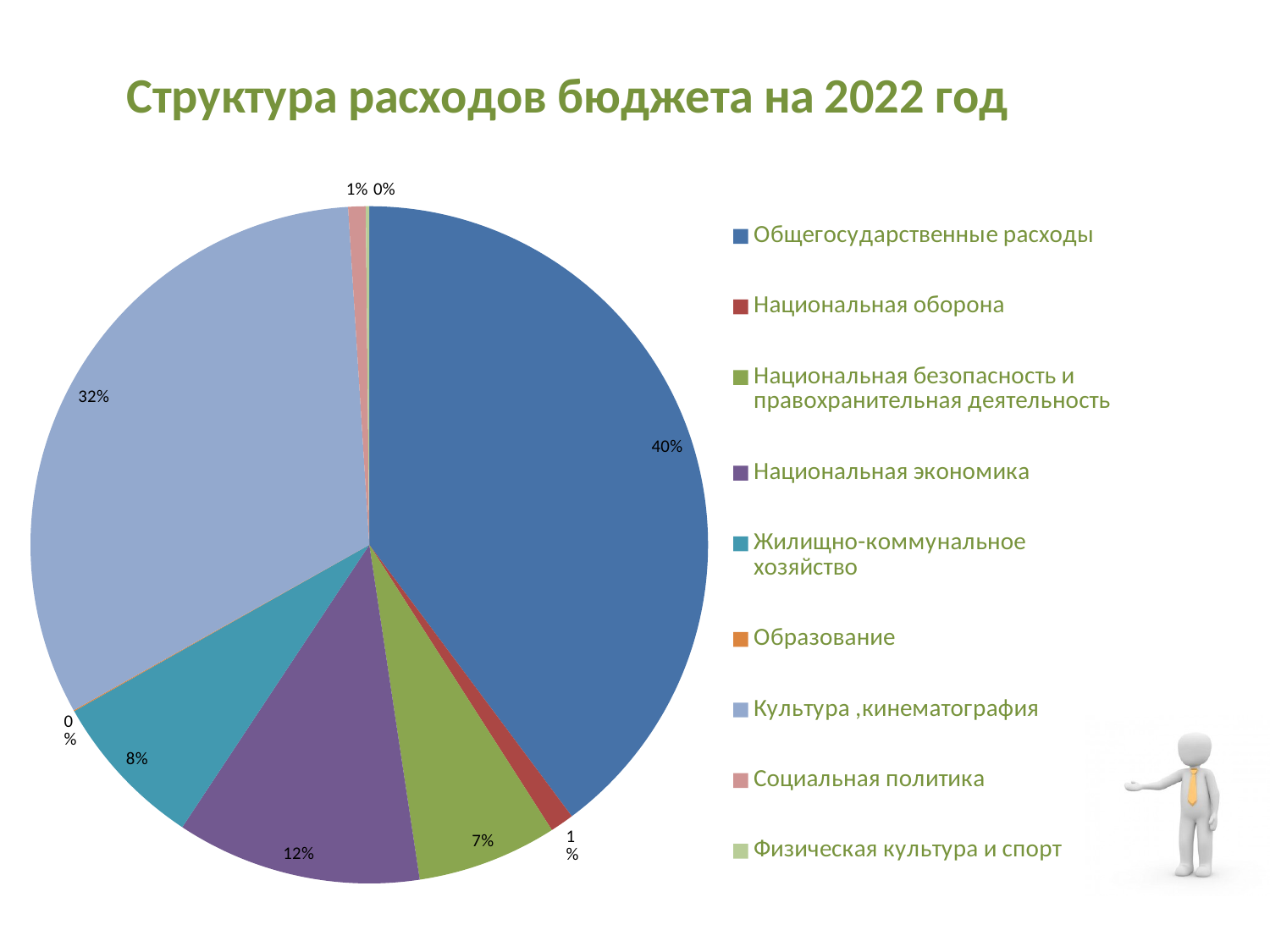
What share of the pie is Культура ,кинематография? 32% Which category has the largest slice of the pie? Общегосударственные расходы Which is larger: the slice for Национальная экономика or the slice for Жилищно-коммунальное хозяйство? Национальная экономика What share of the pie is Национальная безопасность и правохранительная деятельность? 7% What share of the pie is Жилищно-коммунальное хозяйство? 8% What kind of chart is shown on the slide? pie chart What is the difference between the share for Общегосударственные расходы and the share for Культура ,кинематография? 8% What colour is the slice for Национальная экономика? purple What is the title of the chart? Структура расходов бюджета на 2022 год How many categories does the legend list? 9